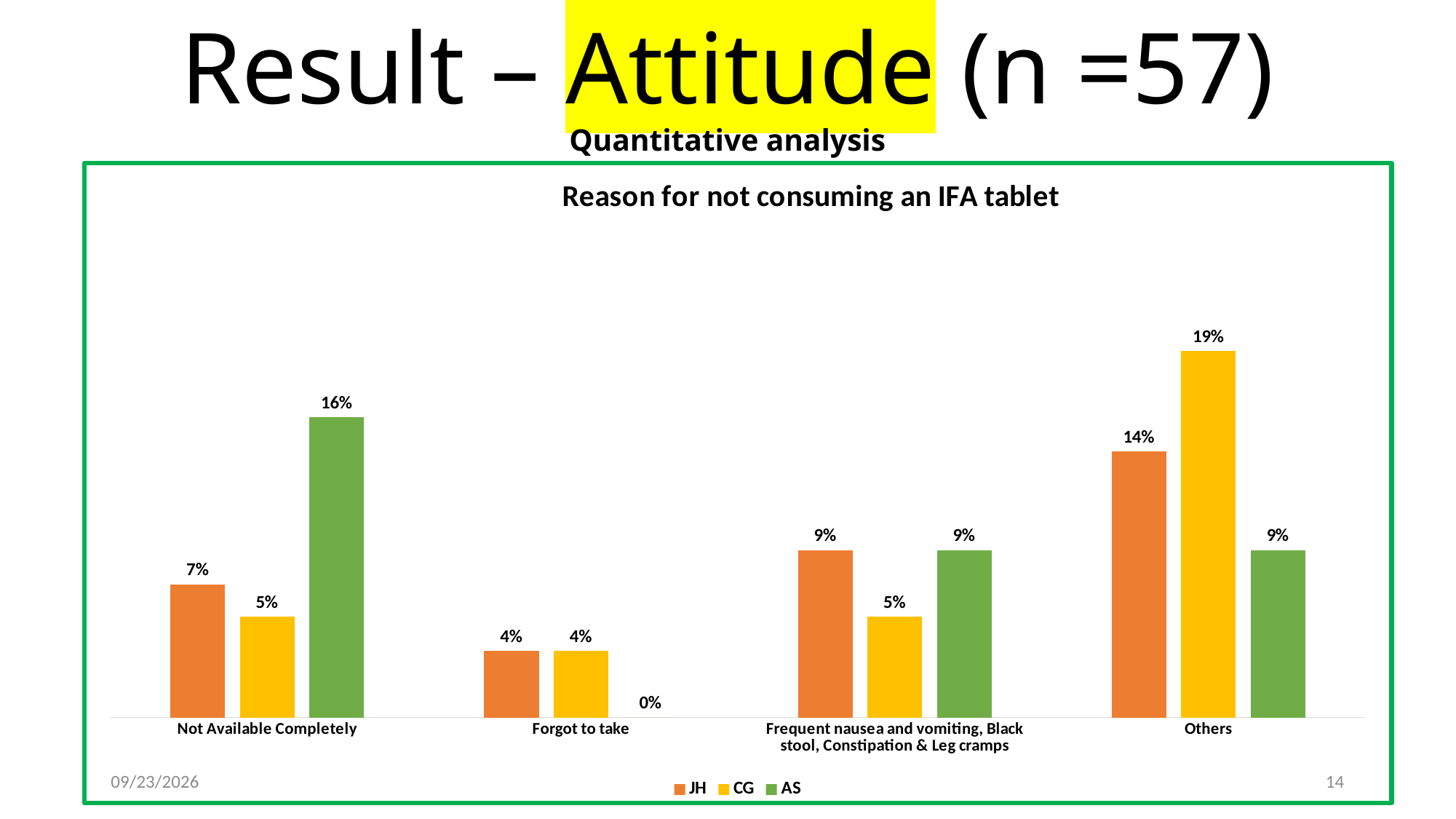
What kind of chart is shown on the slide? Bar chart What is the difference between the CG and AS values in the 'Others' category? 10% What is the value for JH in the 'Forgot to take' category? 4% What is the value for AS in the 'Not Available Completely' category? 16% What is the value for CG in the 'Others' category? 19% How many series does the legend list? 3 Which category has the highest value for the CG series? Others How many categories are shown on the x axis? 4 What is the value for AS in the 'Forgot to take' category? 0% What is the title of the chart? Reason for not consuming an IFA tablet Which is larger in the 'Not Available Completely' category: the JH value or the CG value? JH Which category has the lowest value for the AS series? Forgot to take